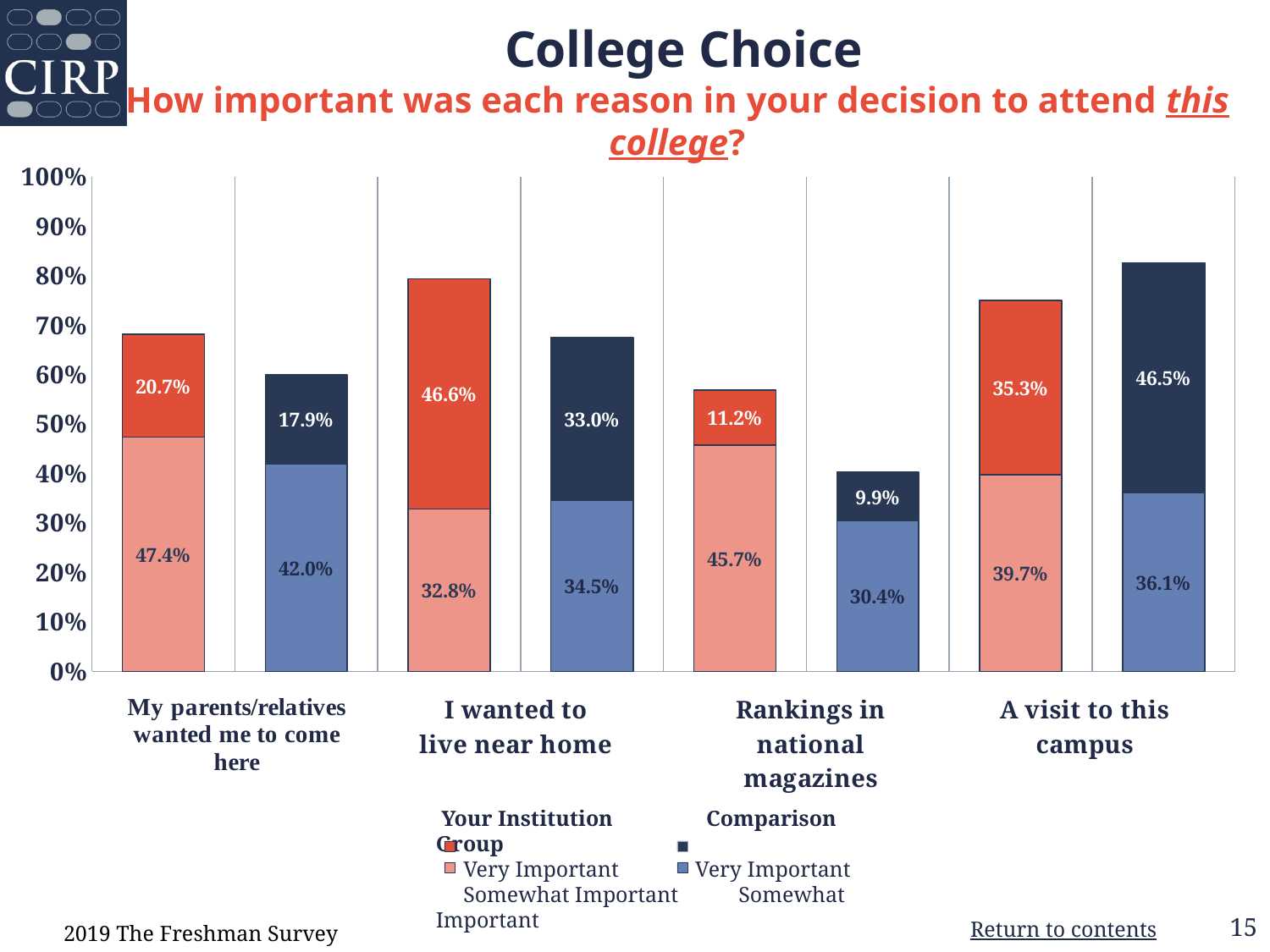
Which reason has the lowest Very Important percentage for the Comparison Group? Rankings in national magazines Which reason has the highest Very Important percentage for Your Institution? I wanted to live near home What is the combined Very Important and Somewhat Important total for Your Institution on "I wanted to live near home"? 79.4% What is the difference between the Your Institution and Comparison Group Very Important percentages for "My parents/relatives wanted me to come here"? 2.8% How many reasons (categories) are shown on the x axis of the chart? 4 How many series does the legend list? 4 What percentage of Your Institution students rated "I wanted to live near home" as Very Important? 46.6% What percentage of the Comparison Group rated "Rankings in national magazines" as Somewhat Important? 30.4% What is the combined Very Important and Somewhat Important total for the Comparison Group on "Rankings in national magazines"? 40.3% What percentage of the Comparison Group rated "A visit to this campus" as Very Important? 46.5% What kind of chart is shown on the slide? Stacked bar chart For "A visit to this campus", which group has the larger Very Important percentage, Your Institution or the Comparison Group? Comparison Group